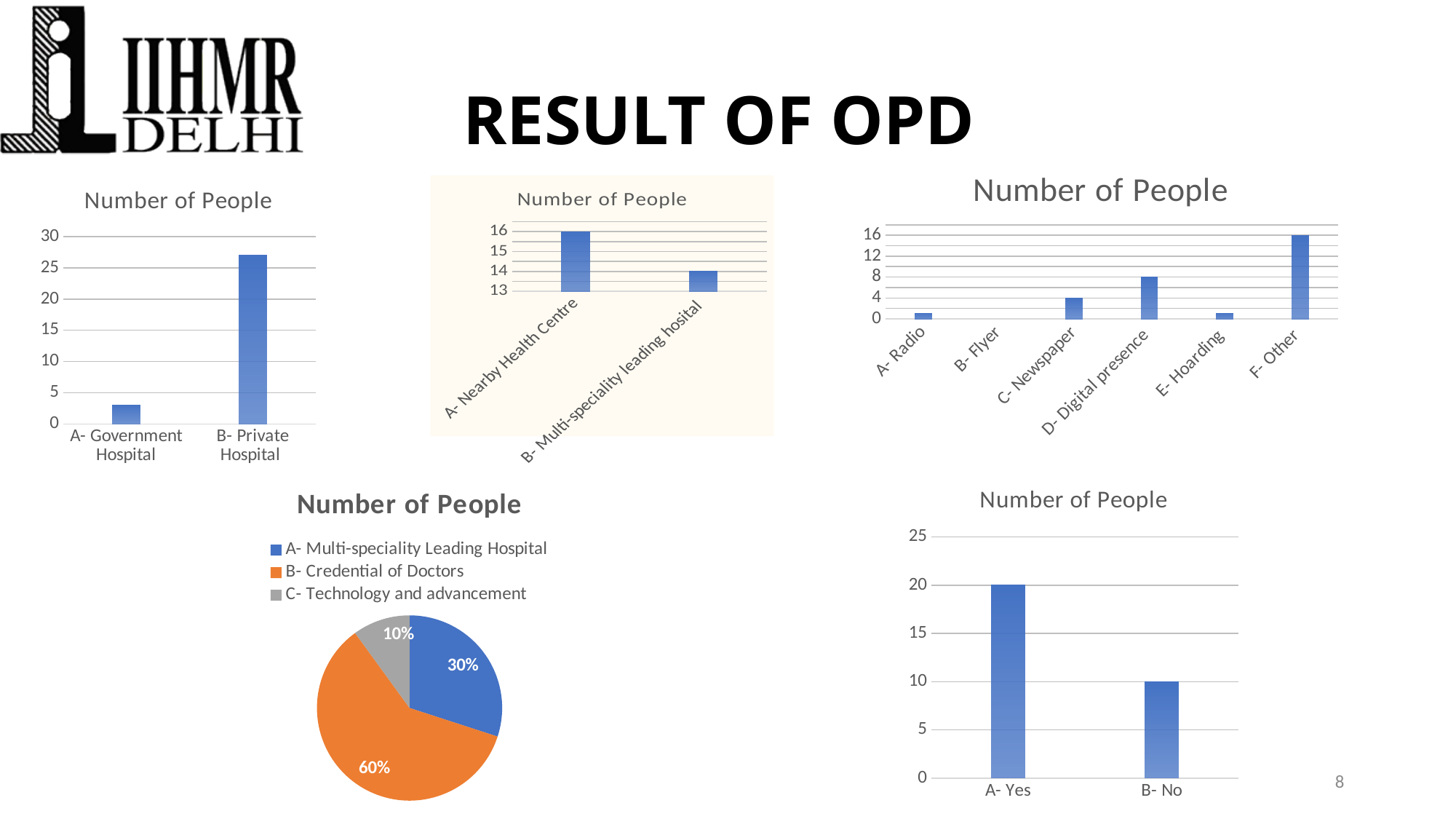
In the top-middle bar chart, what is the value for B- Multi-speciality leading hosital? 14 How many entries does the legend of the bottom-left pie chart list? 3 In the top-right bar chart, what is the value for D- Digital presence? 8 In the top-right bar chart, which category has the highest value? F- Other In the top-middle bar chart, what is the difference between A- Nearby Health Centre and B- Multi-speciality leading hosital? 2 In the top-left bar chart, is the value for A- Government Hospital greater or less than 5? less In the bottom-right bar chart, what is the difference between A- Yes and B- No? 10 In the bottom-right bar chart, what is the value for A- Yes? 20 In the top-left bar chart, is the value for B- Private Hospital greater or less than 25? greater In the top-middle bar chart, what is the value for A- Nearby Health Centre? 16 In the bottom-left pie chart, what share does B- Credential of Doctors have? 60% How many categories are shown in the top-right bar chart? 6